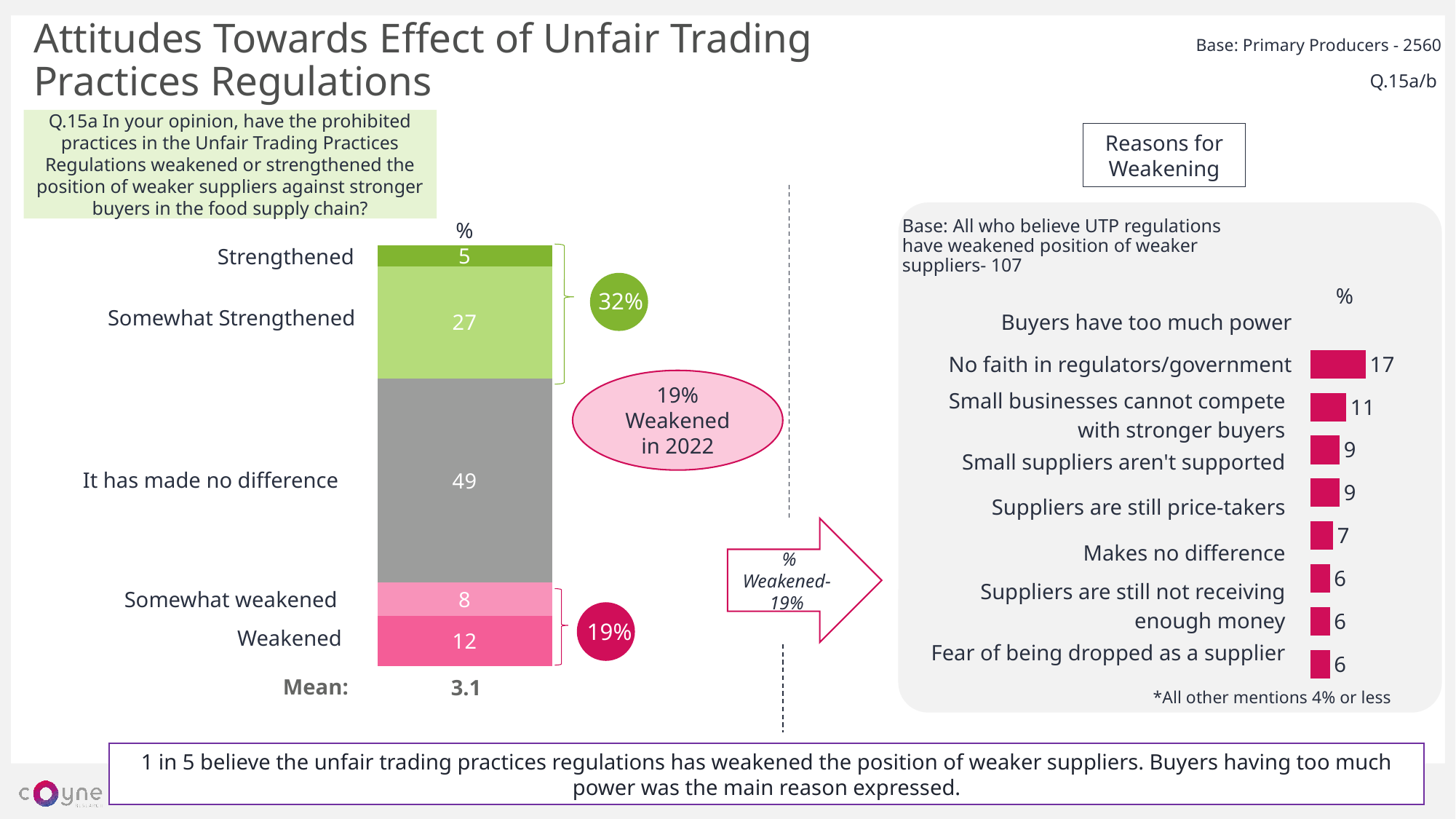
In the stacked bar chart on the left, what percentage of primary producers said the regulations have made no difference? 49 In the stacked bar chart on the left, which category has the lowest value? Strengthened In the stacked bar chart on the left, how many segments make up the stacked bar? 5 In the 'Reasons for Weakening' chart on the right, what is the highest value shown on any bar? 17 In the stacked bar chart on the left, which category has the highest value? It has made no difference What mean value is shown beneath the stacked bar chart on the left? 3.1 What type of chart is the 'Reasons for Weakening' chart on the right? Bar chart In the stacked bar chart on the left, what is the value for 'Somewhat Strengthened'? 27 In the stacked bar chart on the left, what is the combined percentage for 'Strengthened' and 'Somewhat Strengthened' shown in the green circle? 32% In the stacked bar chart on the left, what is the difference between 'Weakened' and 'Somewhat weakened'? 4 In the stacked bar chart on the left, which is larger: 'Somewhat Strengthened' or 'Somewhat weakened'? Somewhat Strengthened In the stacked bar chart on the left, what is the value for 'Weakened'? 12